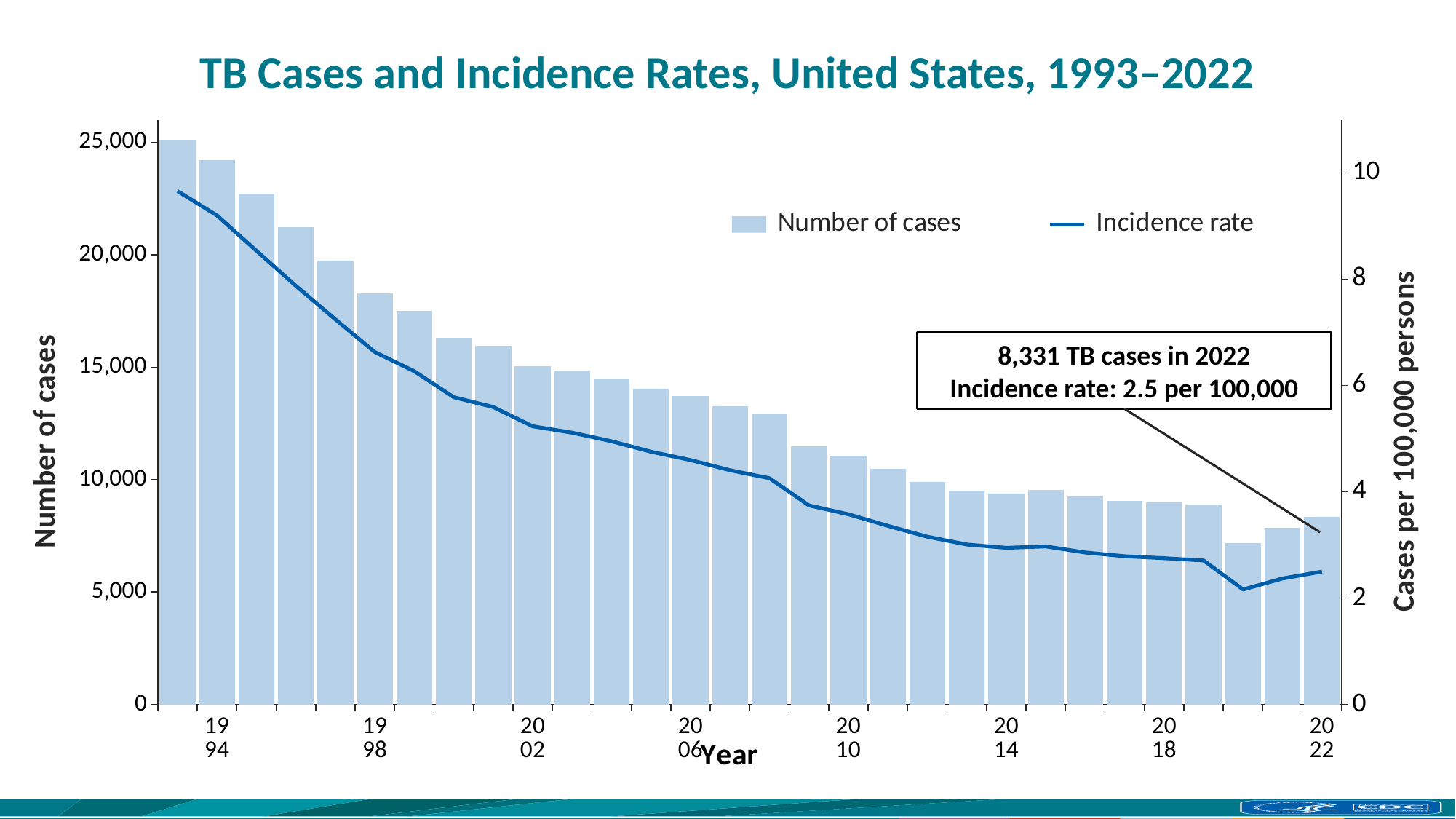
Is the incidence rate in 2018 greater or less than 4 per 100,000? less Does the number of TB cases generally rise or fall from 1993 to 2022? fall How many series does the legend list? 2 Is the incidence rate in 1994 greater or less than 8 per 100,000? greater Which year has the highest number of TB cases? 1993 How many TB cases were reported in 2022 according to the chart? 8,331 Is the number of cases in 2010 greater or less than 15,000? less What was the TB incidence rate in 2022? 2.5 per 100,000 What is the title of the chart? TB Cases and Incidence Rates, United States, 1993–2022 What kind of chart is shown on the slide? A bar chart combined with a line chart Which year had more TB cases, 1998 or 2002? 1998